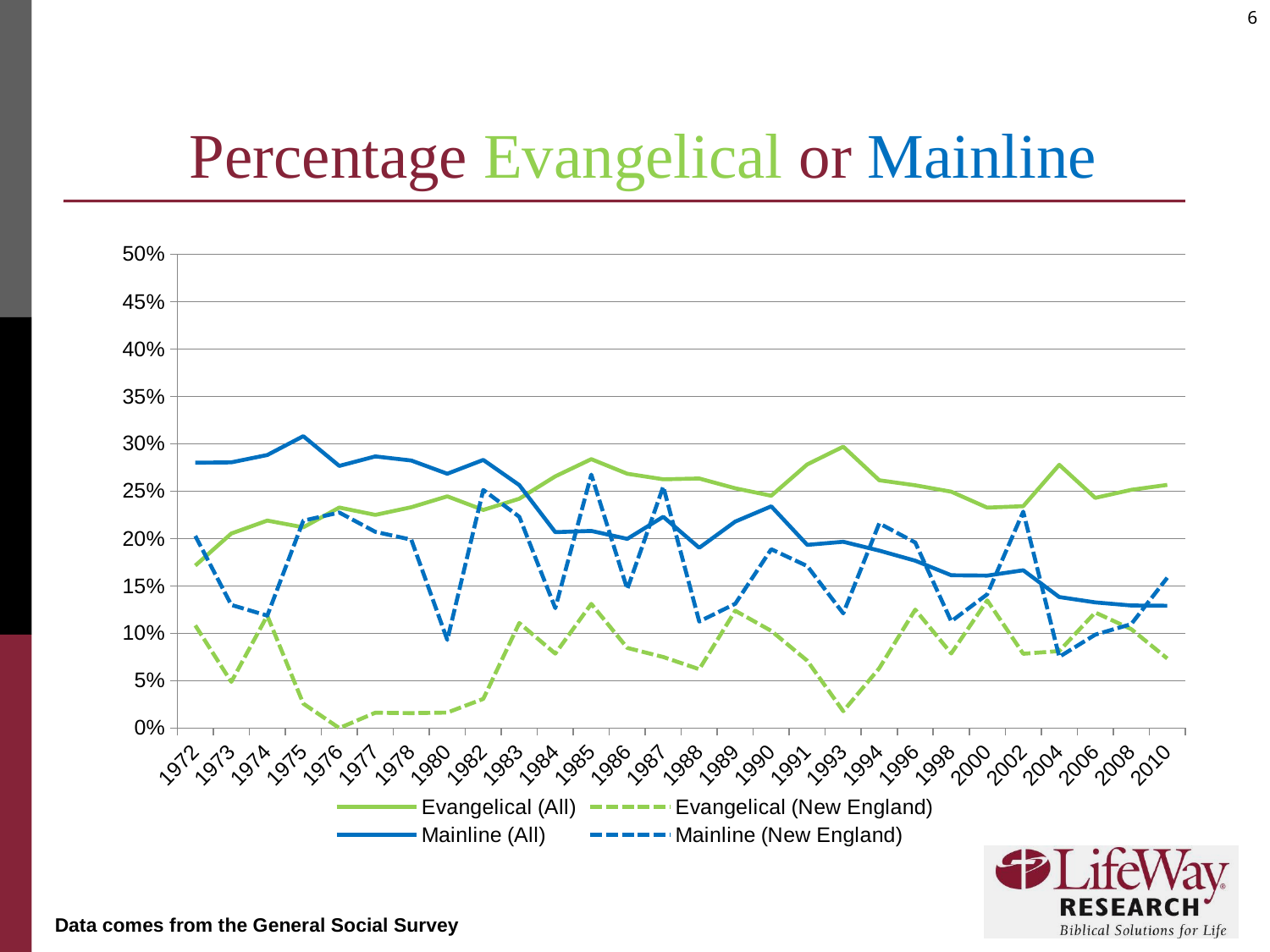
Does the Mainline (All) line generally rise or fall from 1972 to 2010? Fall Is the value for Mainline (All) in 1975 greater or less than 30%? greater How many series does the legend list? 4 What kind of chart is shown on the slide? Line chart Is the value for Evangelical (New England) in 1976 greater or less than 5%? less How many years are plotted along the x axis? 28 In which year does the Mainline (All) series reach its highest value? 1975 Is the value for Evangelical (All) in 1972 greater or less than 20%? less In 1972, which is higher: Mainline (All) or Evangelical (All)? Mainline (All) In 2010, which is higher: Evangelical (All) or Mainline (All)? Evangelical (All) What is the title of the chart? Percentage Evangelical or Mainline